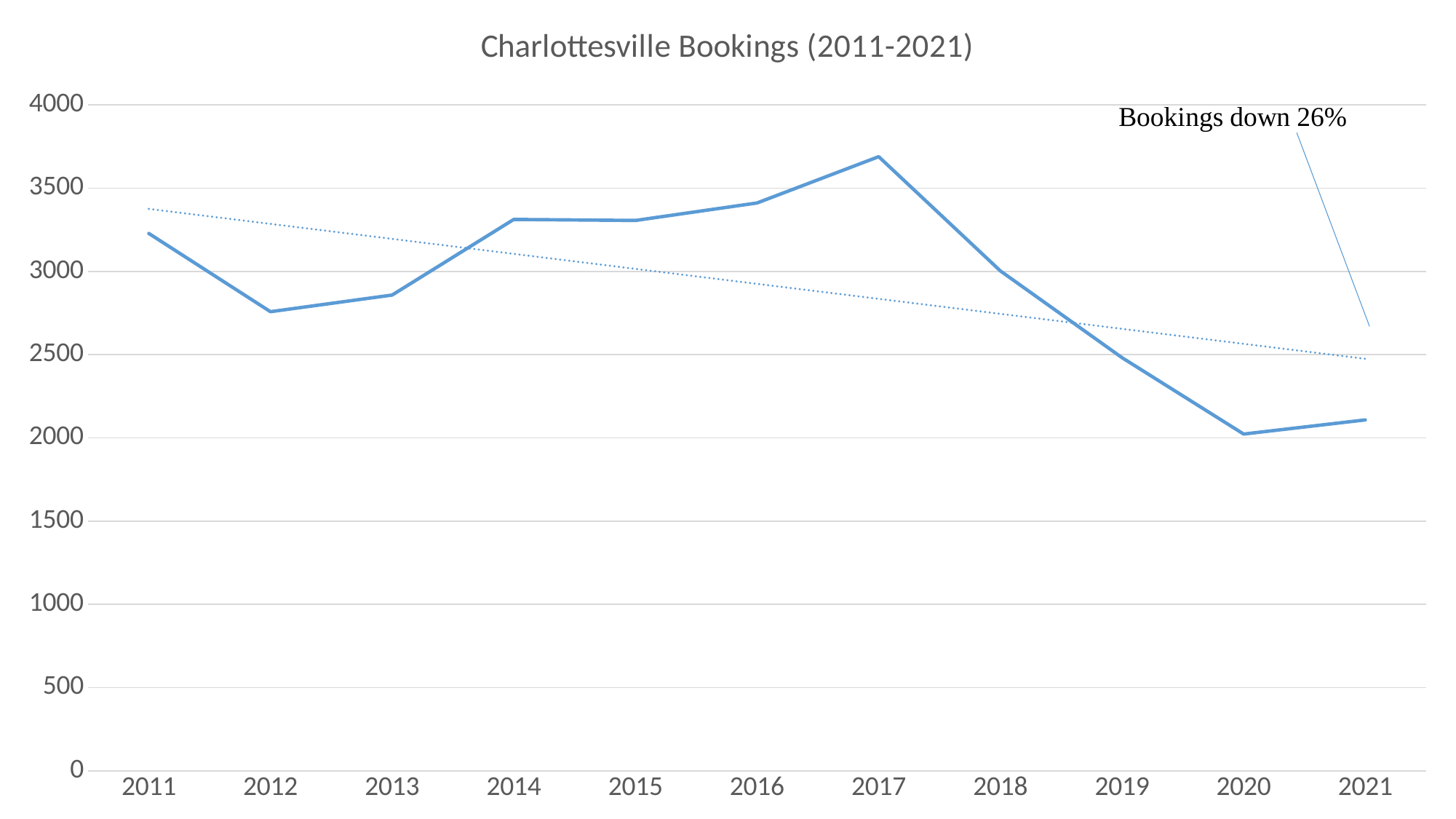
Which year has more bookings, 2017 or 2018? 2017 How many years are plotted on the x axis? 11 Is the value for 2011 greater or less than 3000? greater Is the value for 2021 greater or less than 2500? less What is the title of the chart? Charlottesville Bookings (2011-2021) Do bookings overall rise or fall from 2017 to 2020? fall Which year has the lowest number of bookings? 2020 What does the text annotation on the chart say? Bookings down 26% Which year has the highest number of bookings? 2017 Is the value for 2012 greater or less than 3000? less What kind of chart is shown on the slide? line chart